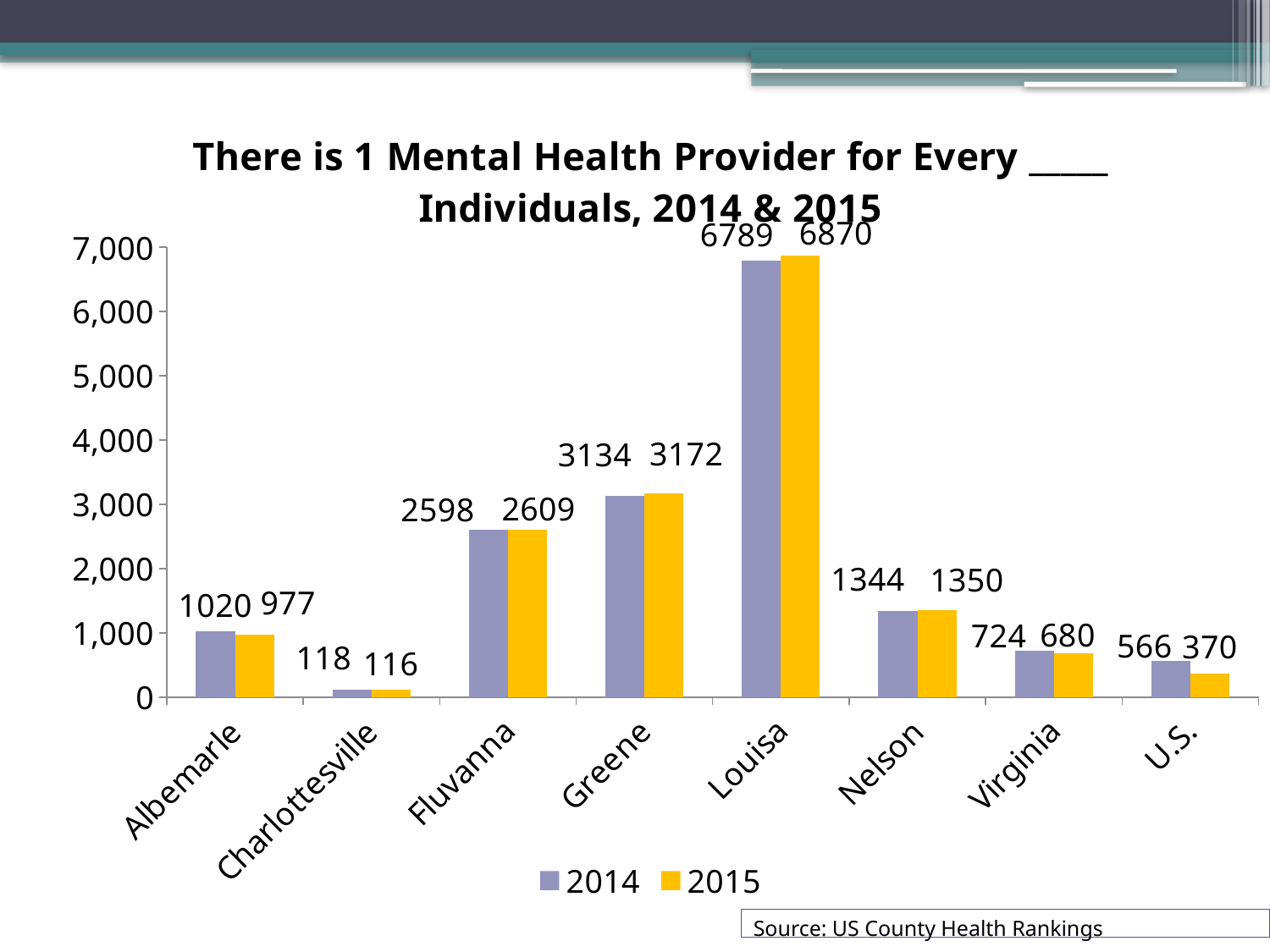
Which category has the lowest 2014 value? Charlottesville What kind of chart is shown on the slide? bar chart How many categories are shown on the x axis? 8 What is the 2014 value for Louisa? 6789 What is the 2015 value for Charlottesville? 116 What is the difference between the 2015 values for Greene and Fluvanna? 563 How many series does the legend list? 2 What is the difference between the 2014 and 2015 values for U.S.? 196 Which is larger, the 2014 value for Albemarle or the 2014 value for Nelson? Nelson Is the 2015 value for Greene greater or less than 3,000? greater Which category has the highest 2015 value? Louisa What is the 2015 value for U.S.? 370